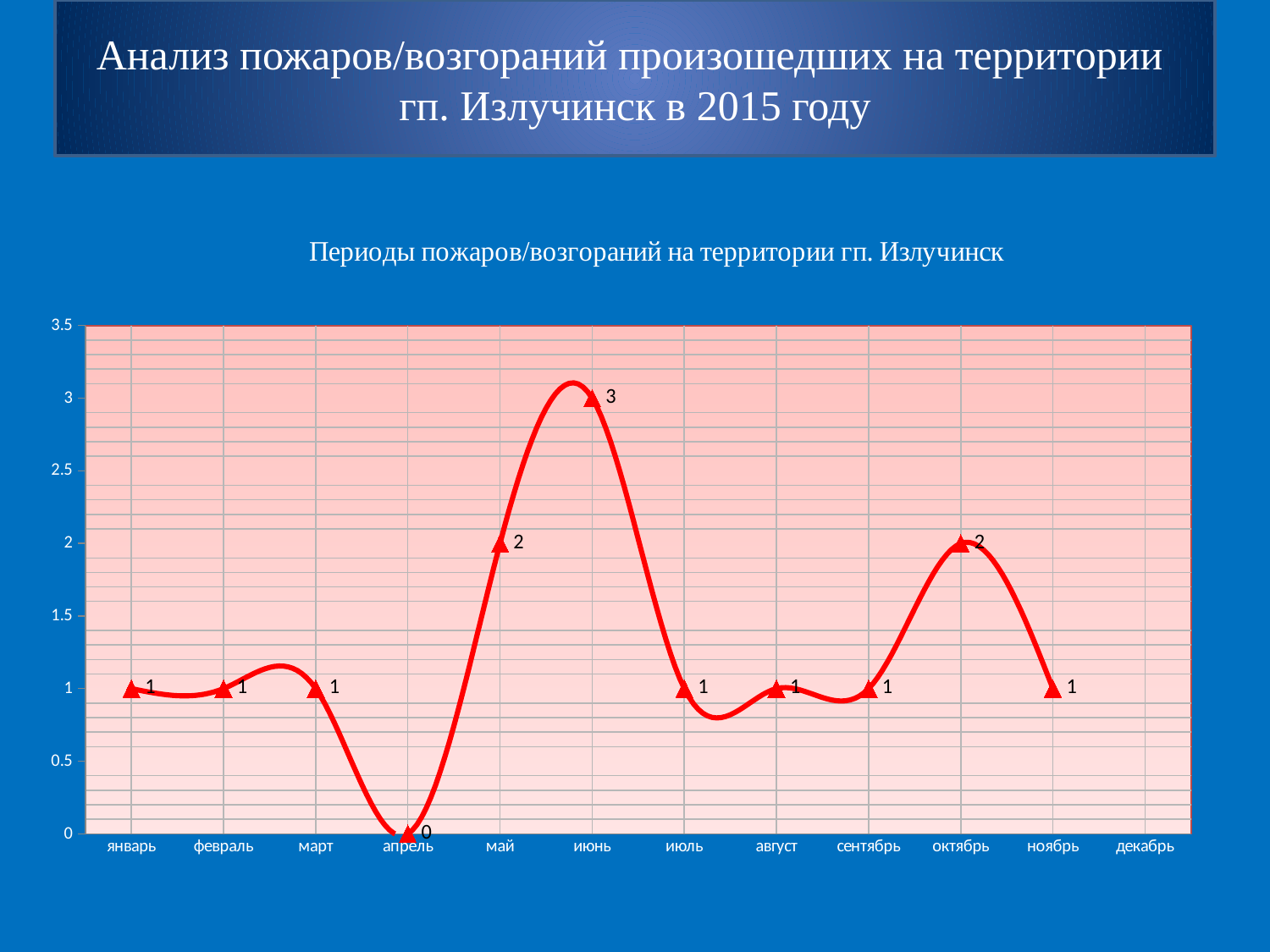
What is the value for май? 2 Which is larger, the value for октябрь or the value for ноябрь? октябрь Which month has the lowest plotted value? апрель What is the value for апрель? 0 Which month has the highest value? июнь How many months are listed on the x axis? 12 What is the difference between the values for июнь and май? 1 Do the values rise or fall from апрель to июнь? rise What is the value for июнь? 3 What type of chart is shown on the slide? line chart What is the title of the chart? Периоды пожаров/возгораний на территории гп. Излучинск What is the value for октябрь? 2